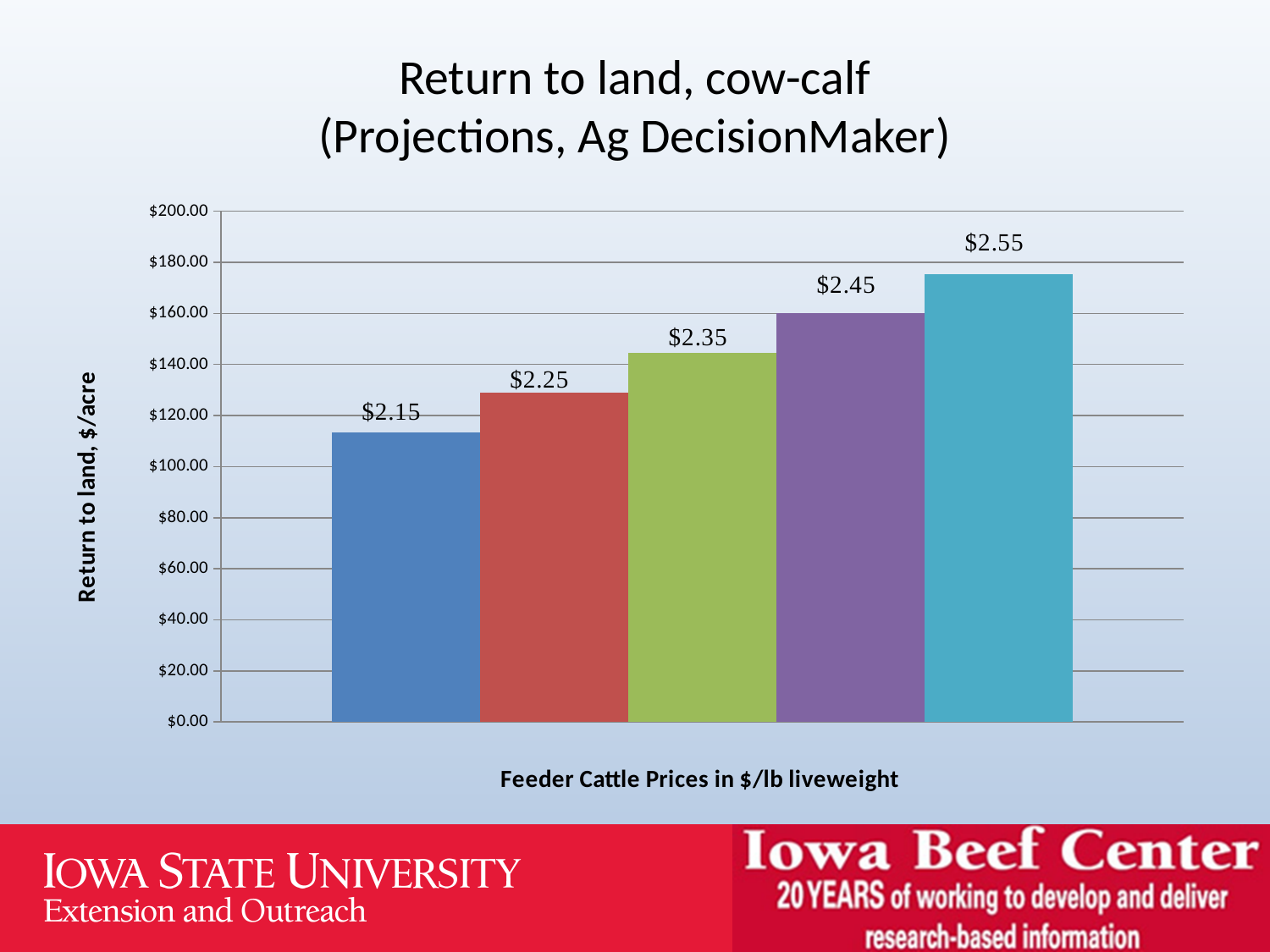
Do the return to land values rise or fall as the feeder cattle price increases along the x axis? rise What is the label of the x axis of the chart? Feeder Cattle Prices in $/lb liveweight Which feeder cattle price has the lowest return to land? $2.15 Which feeder cattle price has the highest return to land? $2.55 What is the label of the y axis of the chart? Return to land, $/acre What kind of chart is shown on the slide? bar chart How many feeder cattle price categories are plotted in the chart? 5 Is the return to land for the $2.25 feeder cattle price greater or less than $120.00? greater Is the return to land for the $2.35 feeder cattle price greater or less than $140.00? greater Is the return to land for the $2.15 feeder cattle price greater or less than $120.00? less Which has a larger return to land, the $2.45 or the $2.25 feeder cattle price? $2.45